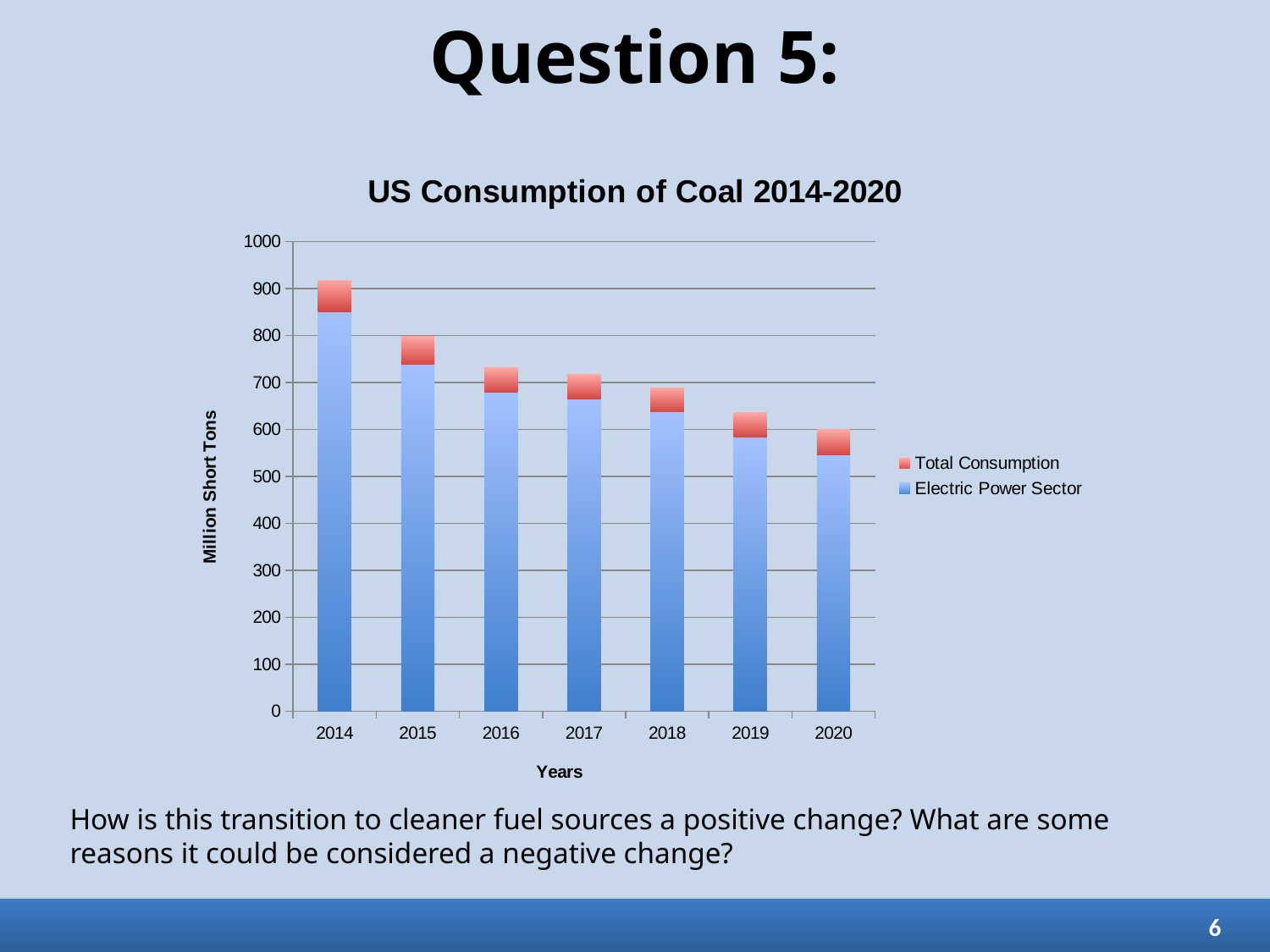
What is the title of the chart? US Consumption of Coal 2014-2020 What kind of chart is shown on the slide? Bar chart Is the Electric Power Sector value for 2015 greater or less than 700? greater Which year has the shortest bar? 2020 Which year has the tallest bar? 2014 How many years are shown on the x axis? 7 What is the label on the y axis? Million Short Tons Is the Electric Power Sector value for 2018 greater or less than 600? greater Is the Electric Power Sector value for 2014 greater or less than 800? greater Do the bars rise or fall from 2014 to 2020? Fall How many series does the legend list? 2